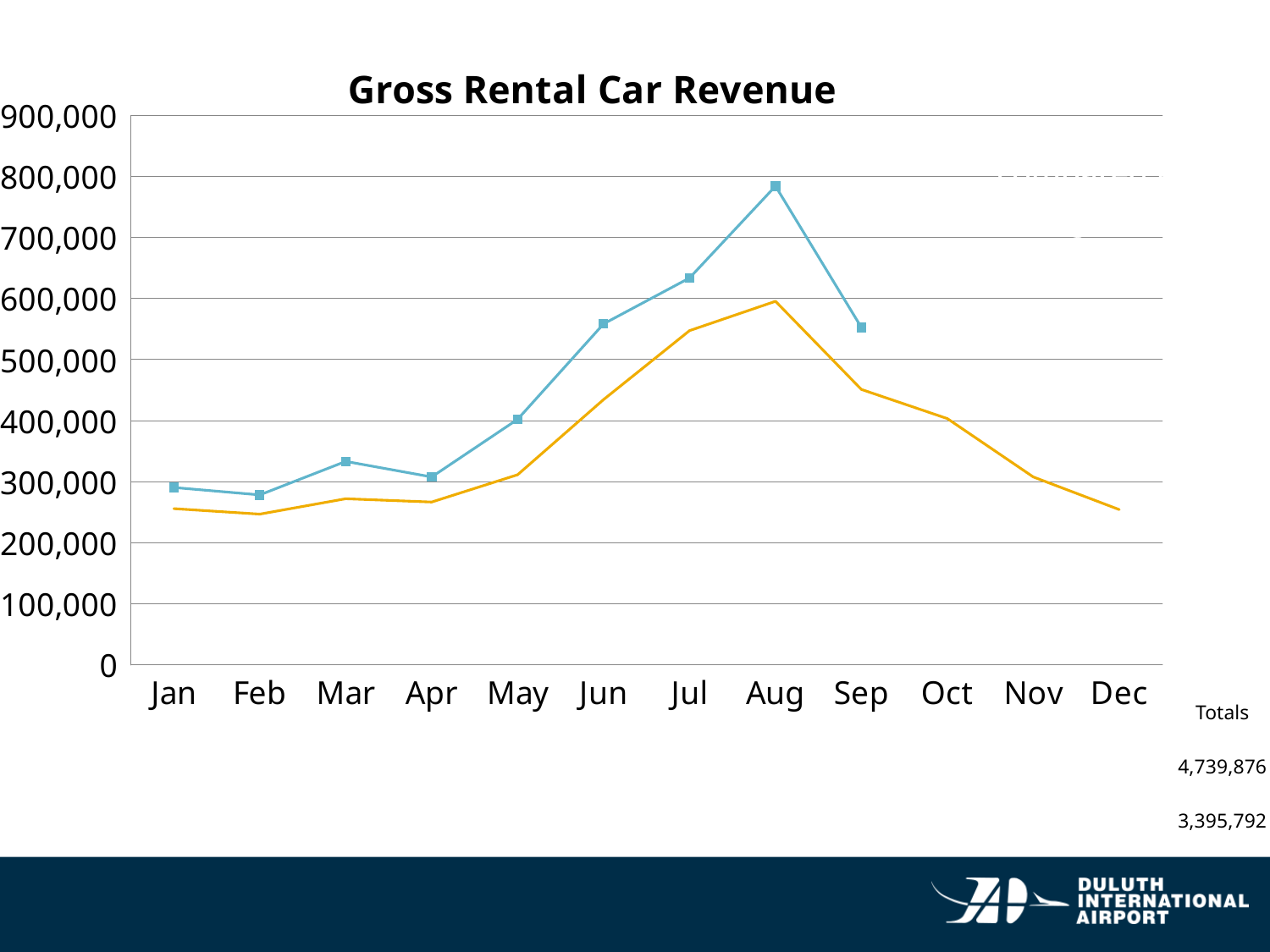
Does the orange line rise or fall from Aug to Dec? fall Is the value of the blue line with square markers in Mar greater or less than 300,000? greater Is the value of the blue line with square markers in Aug greater or less than 700,000? greater How many months does the blue line with square markers cover? 9 In which month does the orange line reach its highest value? Aug Is the value of the orange line in Aug greater or less than 500,000? greater What kind of chart is shown on the slide? line chart How many months are shown on the x axis of the chart? 12 In which month does the blue line with square markers reach its highest value? Aug What is the title of the chart? Gross Rental Car Revenue In Aug, which line has the higher value, the blue line with square markers or the orange line? the blue line with square markers